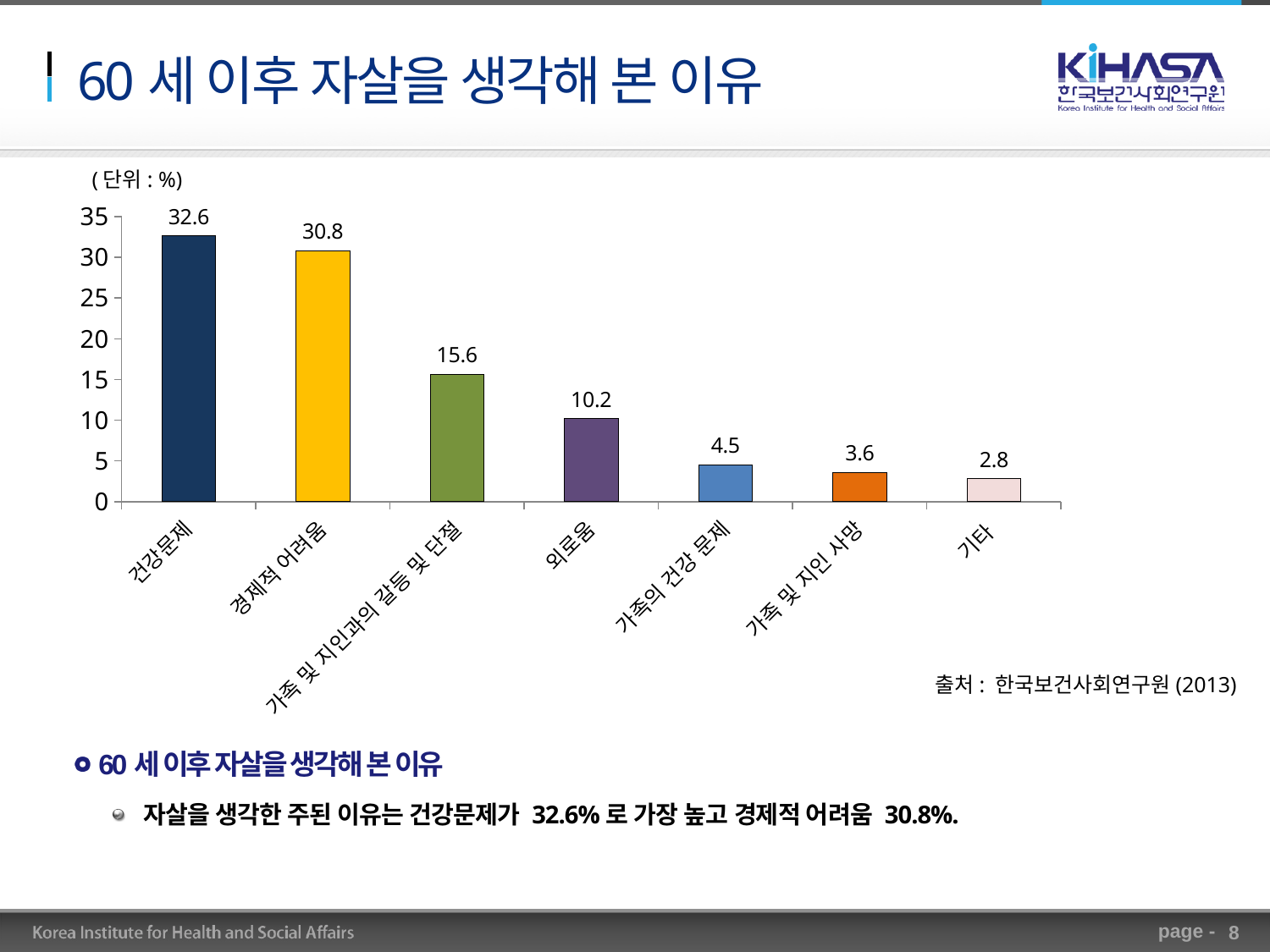
What is the difference between the values for 가족 및 지인과의 갈등 및 단절 and 외로움? 5.4 Which is larger, the value for 가족의 건강 문제 or the value for 기타? 가족의 건강 문제 Which category has the lowest value? 기타 What kind of chart is shown on the slide? bar chart What is the value for 가족 및 지인 사망? 3.6 What is the value for 건강문제? 32.6 What unit is indicated for the chart values? % What is the difference between the values for 건강문제 and 경제적 어려움? 1.8 What is the value for 경제적 어려움? 30.8 How many categories are shown in the chart? 7 Which category has the highest value? 건강문제 What is the value for 외로움? 10.2